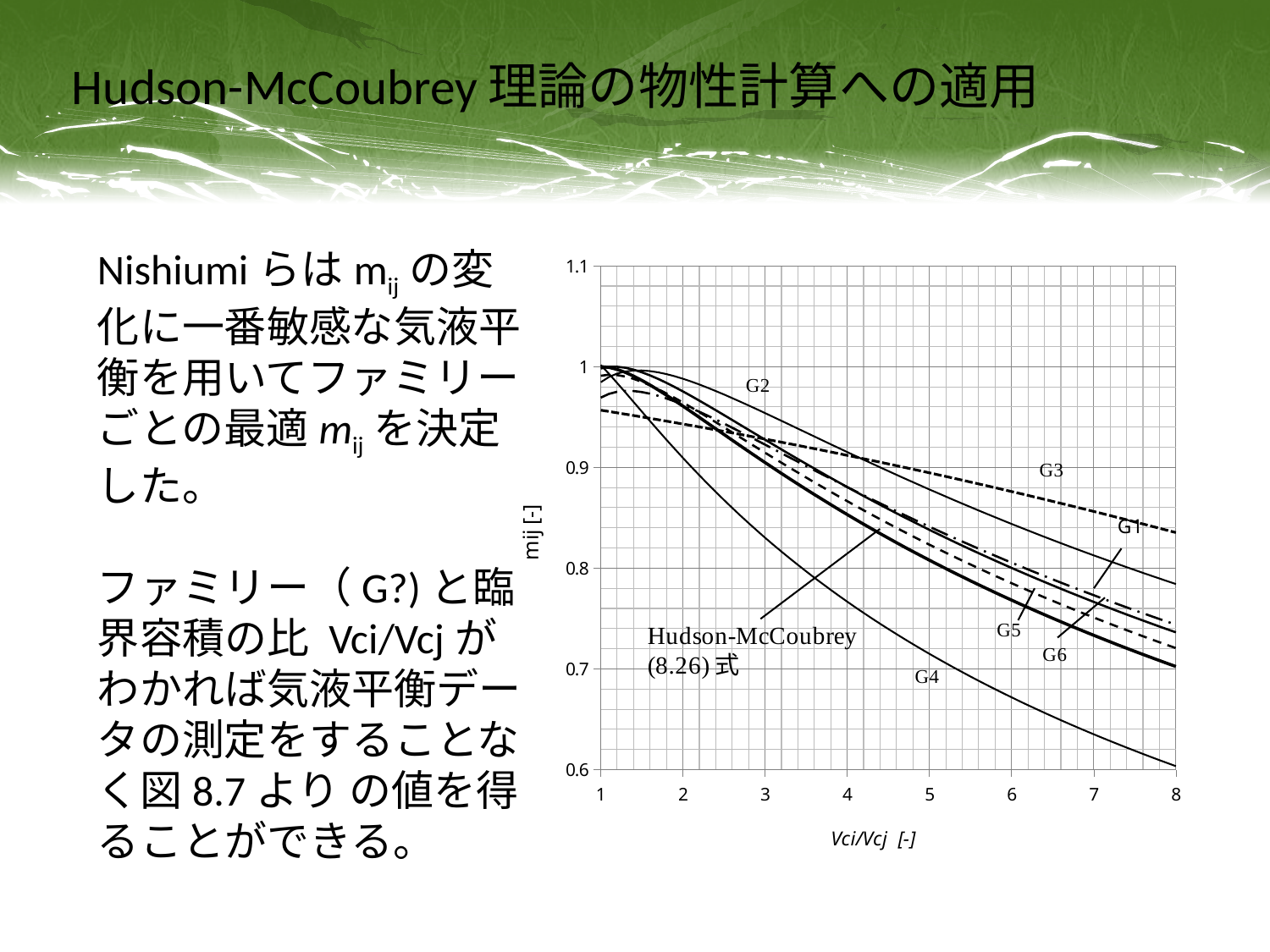
How many curves are plotted on the chart (including the Hudson-McCoubrey curve)? 7 Which curve has the highest mij value at Vci/Vcj = 8? G3 Is the value of G4 at Vci/Vcj = 5 greater or less than 0.8? less Is the value of G3 at Vci/Vcj = 3 greater or less than 0.9? greater What is the highest tick value shown on the y axis? 1.1 Is the value of G3 at Vci/Vcj = 8 greater or less than 0.8? greater Do the curves rise or fall as Vci/Vcj increases from 1 to 8? fall What is the label of the x axis of the chart? Vci/Vcj [-] What is the label of the y axis of the chart? mij [-] Which curve has the lowest mij value at Vci/Vcj = 8? G4 At Vci/Vcj = 6, which curve has the larger mij value, G2 or G4? G2 What kind of chart is shown on the slide? line chart